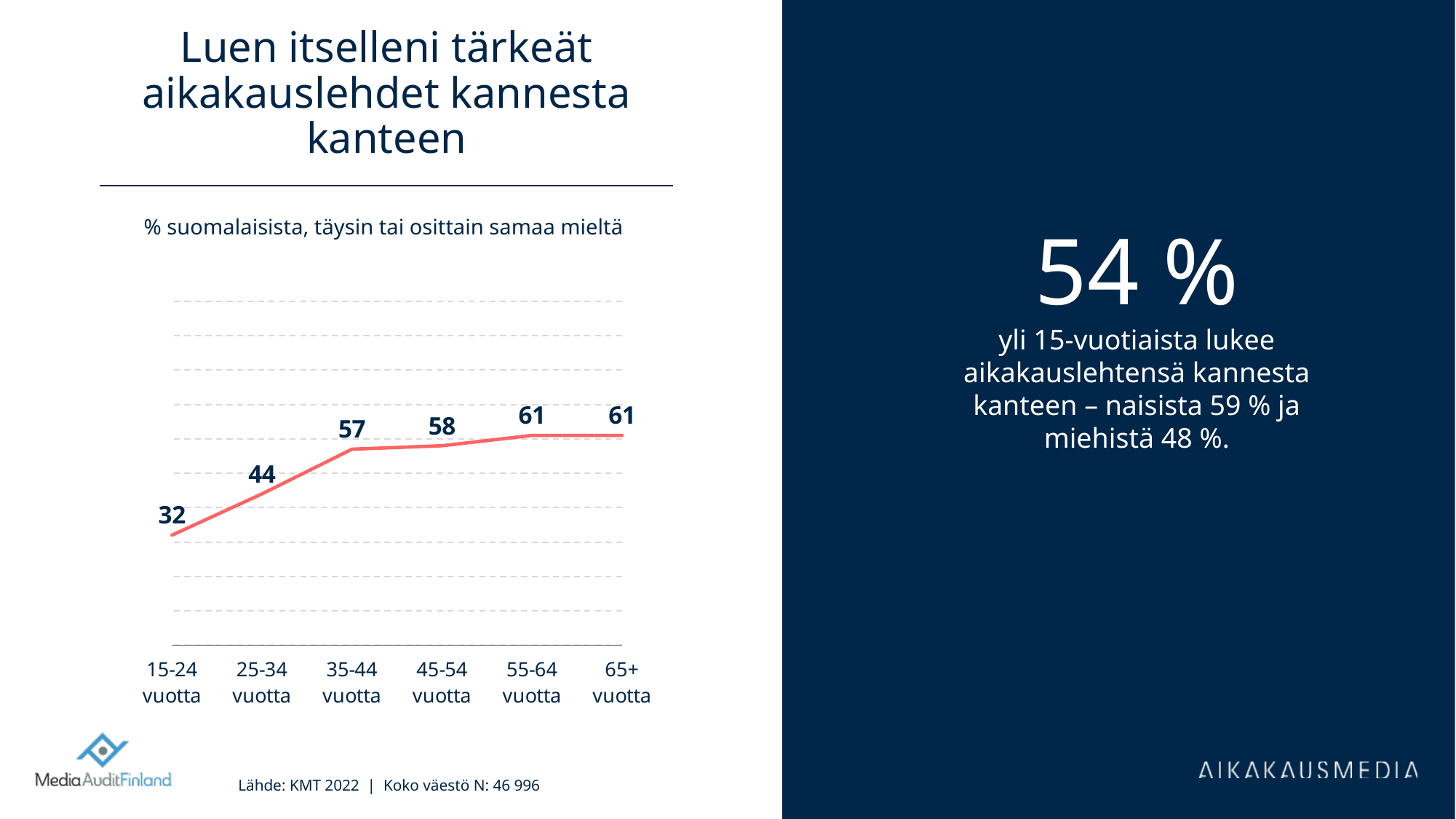
What colour is the line in the chart? red What is the difference between the values for 65+ vuotta and 15-24 vuotta? 29 Which age group has the lowest value? 15-24 vuotta What is the value for the 35-44 vuotta age group? 57 What is the title of the chart? Luen itselleni tärkeät aikakauslehdet kannesta kanteen What is the difference between the values for 25-34 vuotta and 15-24 vuotta? 12 What is the value for the 45-54 vuotta age group? 58 Do the values rise or fall from the youngest to the oldest age group? rise What kind of chart is shown on the slide? line chart What is the value for the 15-24 vuotta age group? 32 Which is larger, the value for 25-34 vuotta or the value for 35-44 vuotta? 35-44 vuotta How many age groups are plotted on the chart? 6